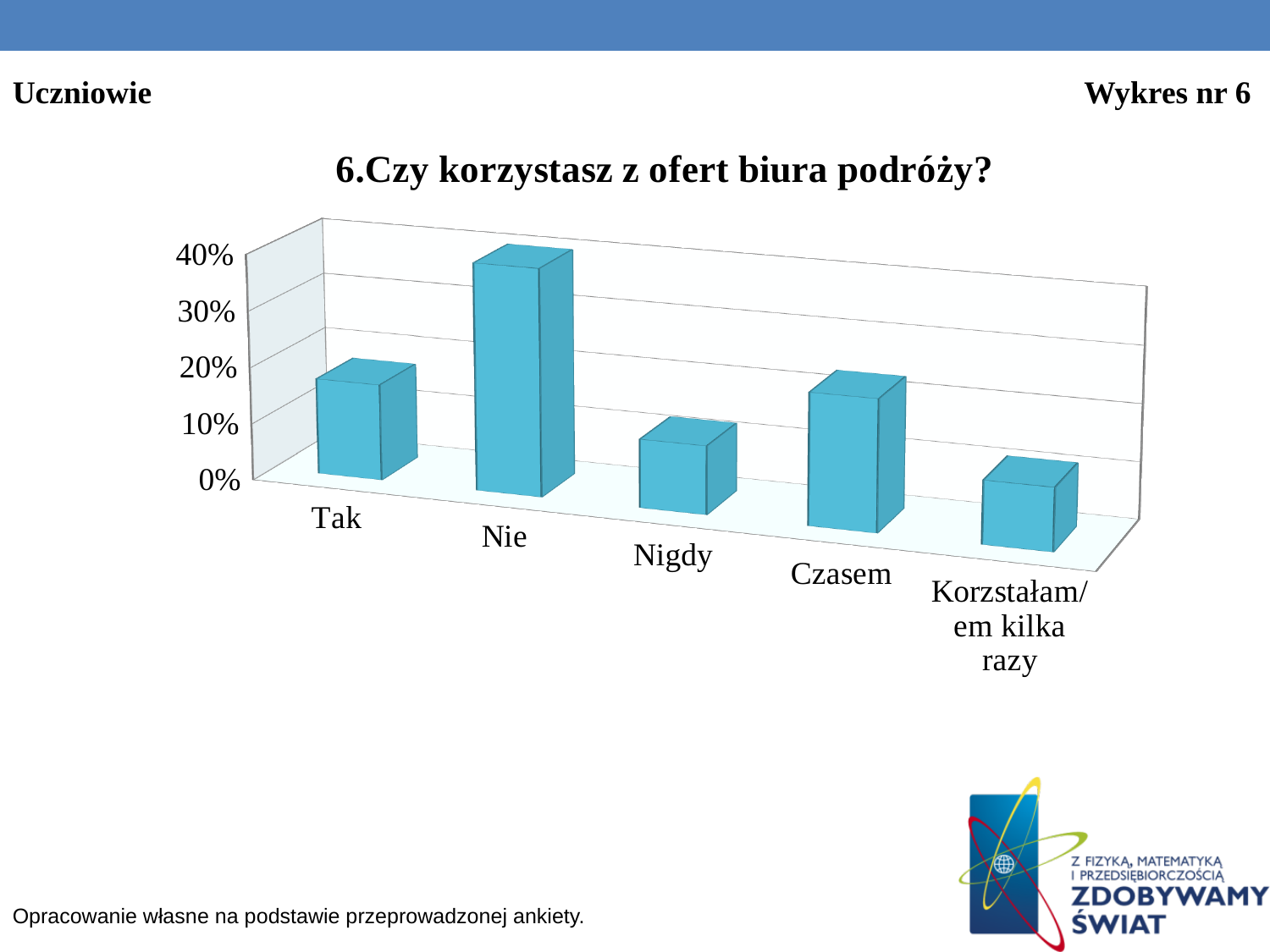
How many categories are shown on the x axis of the chart? 5 What kind of chart is shown on the slide? bar chart Is the value for Nie greater or less than 30%? greater Which category has the highest value? Nie Which is larger, the value for Czasem or the value for Nigdy? Czasem What is the title of the chart? 6.Czy korzystasz z ofert biura podróży? Is the value for Tak greater or less than 10%? greater Is the value for Czasem greater or less than 30%? less Which is larger, the value for Nie or the value for Tak? Nie What is the highest value shown on the vertical axis of the chart? 40%